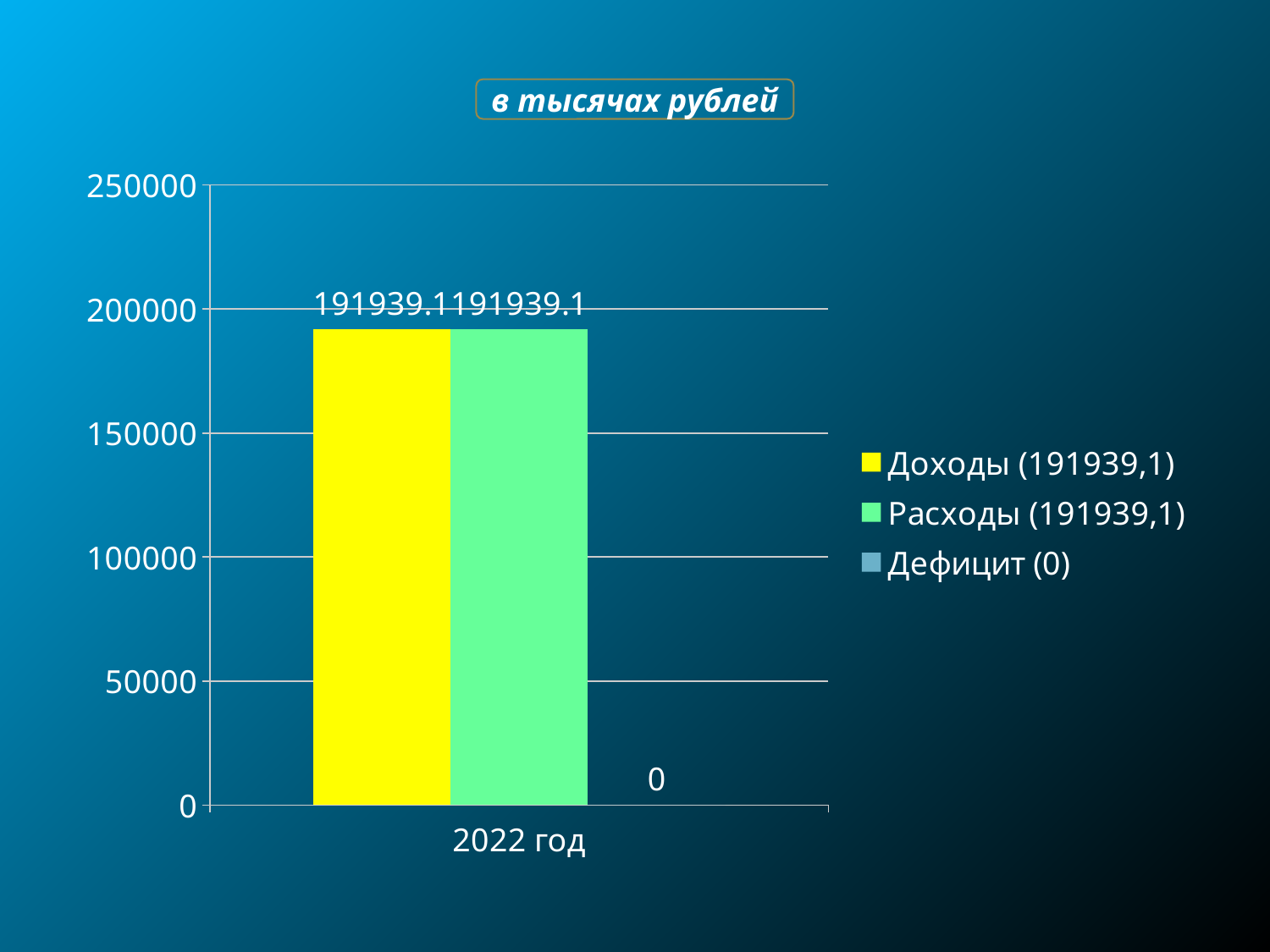
How many series does the legend list? 3 Which series has the lowest value for 2022 год? Дефицит Is the value for Доходы greater or less than 150000? greater What is the value of Дефицит for 2022 год? 0 What unit label is shown above the chart? в тысячах рублей What is the value of Расходы for 2022 год? 191939.1 How many categories are shown on the x axis? 1 What is the value of Доходы for 2022 год? 191939.1 What kind of chart is shown on the slide? bar chart Is the value for Расходы greater or less than 200000? less Which is larger for 2022 год, Доходы or Дефицит? Доходы What is the difference between Доходы and Расходы for 2022 год? 0